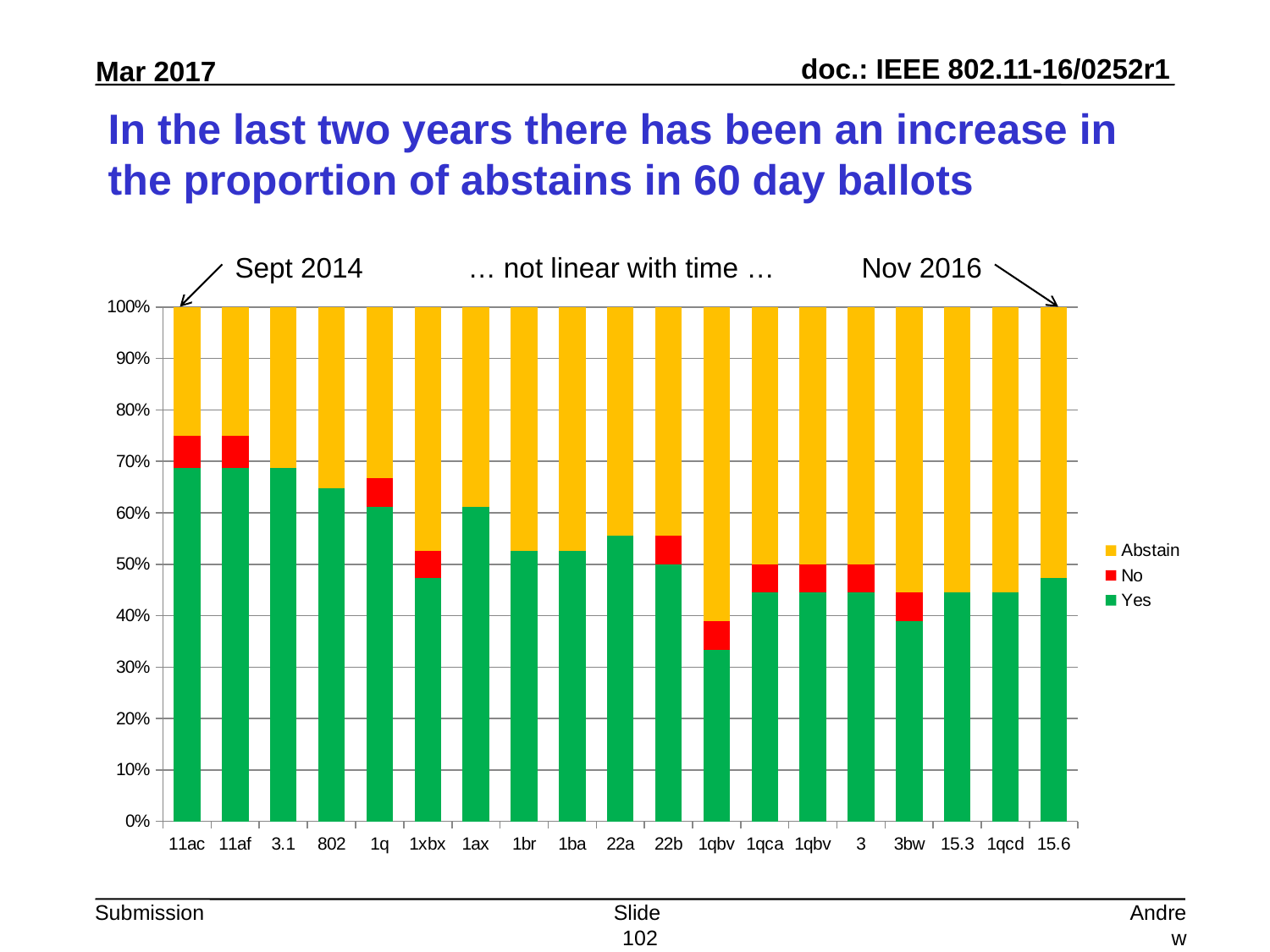
Is the Yes share for 1qca greater or less than 50%? less Is the Yes share for 1xbx greater or less than 50%? less Which series are listed in the legend? Abstain, No, Yes Does the Yes share generally rise or fall from left to right across the ballots? fall Is the Yes share for 11ac greater or less than 60%? greater What colour represents the Abstain series? Yellow Which has the larger Yes share, 11ac or 1qca? 11ac How many series does the legend list? 3 What kind of chart is shown on the slide? Stacked bar chart How many ballot categories are shown along the x axis? 19